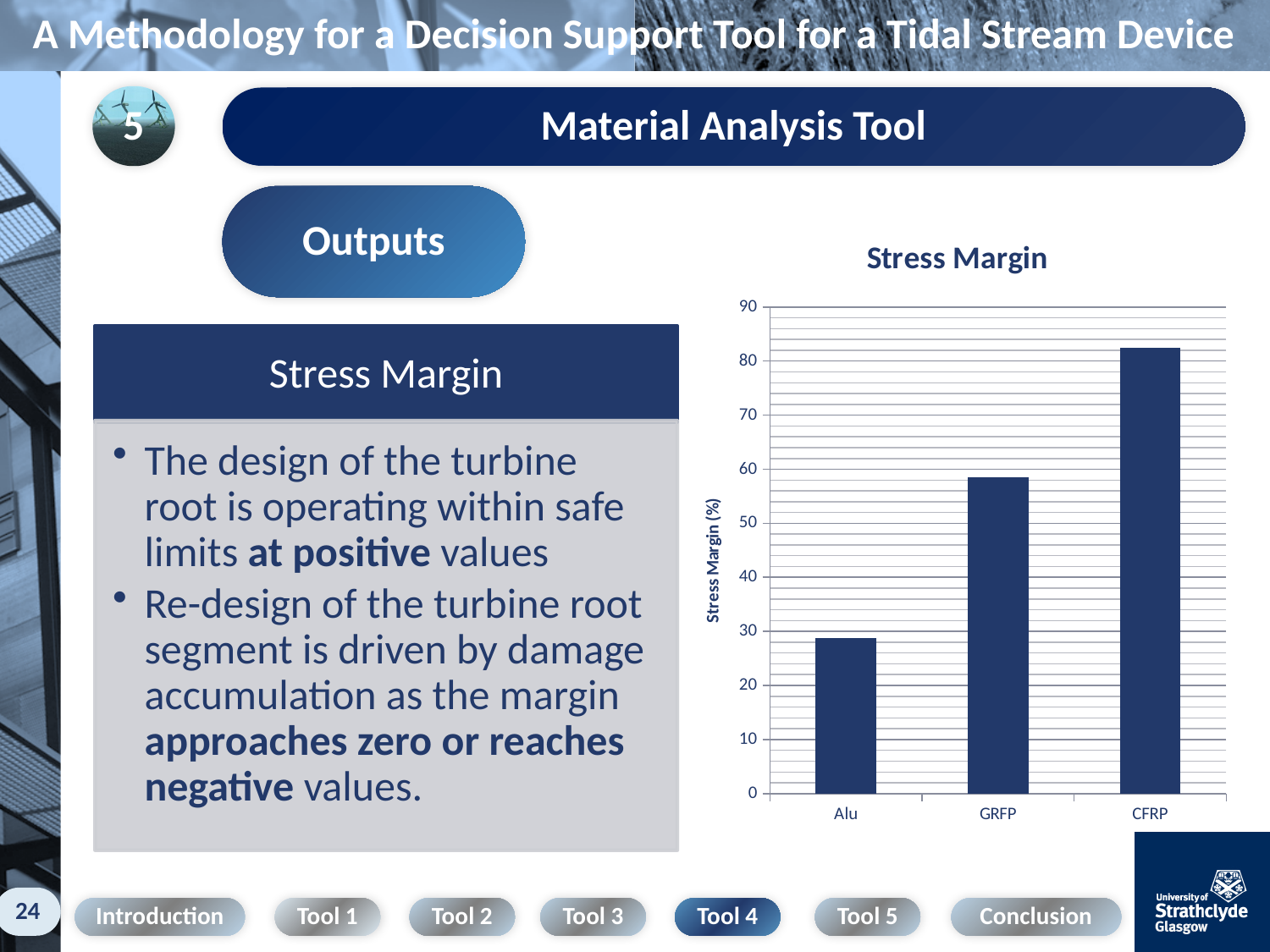
Which has a larger stress margin, CFRP or GRFP? CFRP Is the value for GRFP greater or less than 50? greater Which category has the highest stress margin? CFRP How many categories are shown on the x axis of the Stress Margin chart? 3 What is the title of the chart? Stress Margin What is the label of the vertical axis of the chart? Stress Margin (%) Which category has the lowest stress margin? Alu Do the bar values rise or fall from Alu to CFRP along the x axis? rise Is the value for CFRP greater or less than 80? greater Is the value for Alu greater or less than 30? less Which has a larger stress margin, GRFP or Alu? GRFP What kind of chart is shown on the slide? bar chart